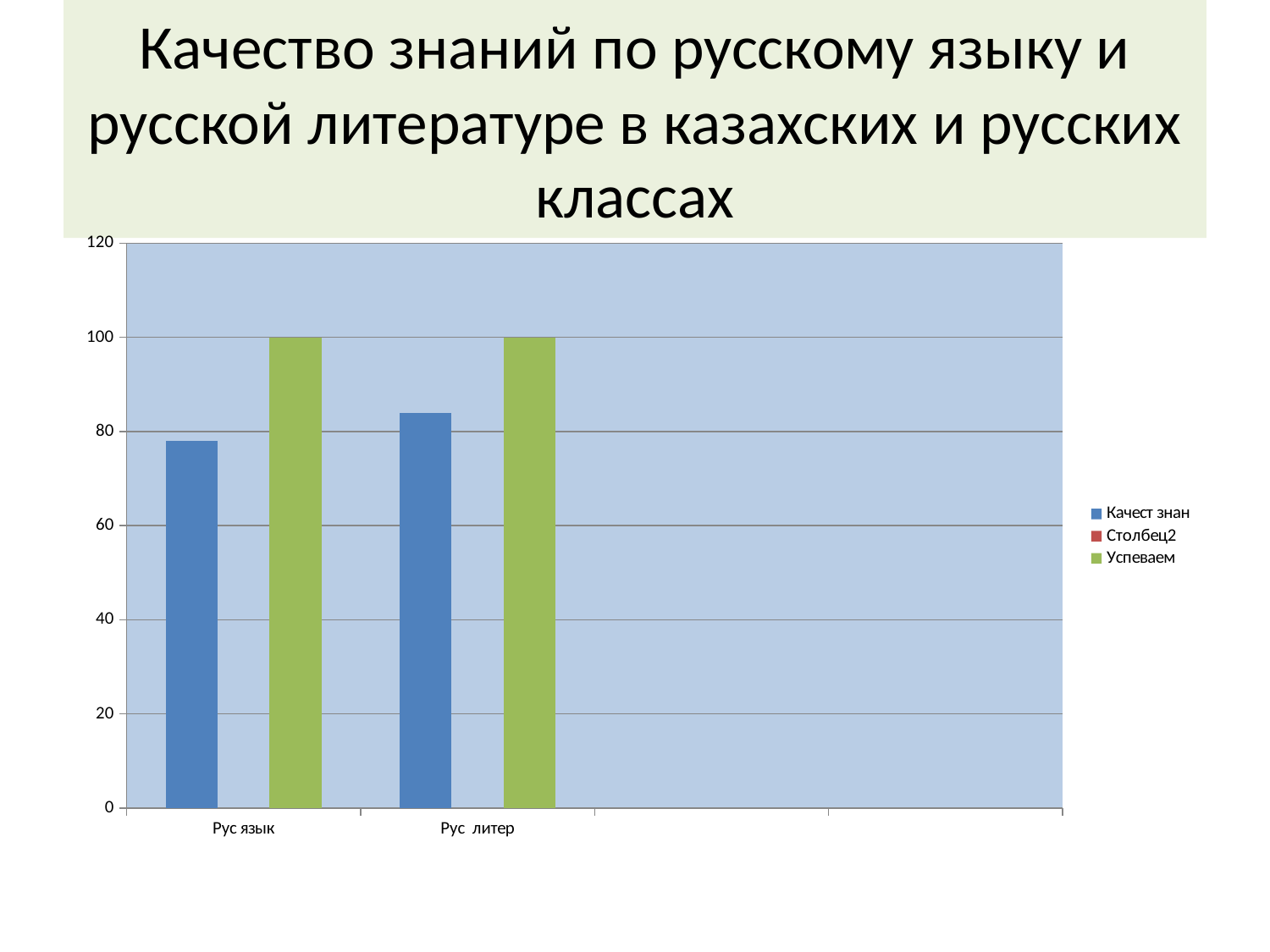
Which category has the higher value for Качест знан, Рус язык or Рус литер? Рус литер Is the value of Качест знан for Рус литер greater or less than 80? greater What kind of chart is shown on the slide? bar chart What colour are the bars for the Успеваем series? green How many categories are shown on the x axis? 2 What is the value of Успеваем for Рус язык? 100 For Рус язык, which series has the larger value, Качест знан or Успеваем? Успеваем Is the value of Качест знан for Рус язык greater or less than 80? less How many series does the legend list? 3 Which category has the highest value for Качест знан? Рус литер Does the value of Качест знан rise or fall from Рус язык to Рус литер? rise What is the value of Успеваем for Рус литер? 100